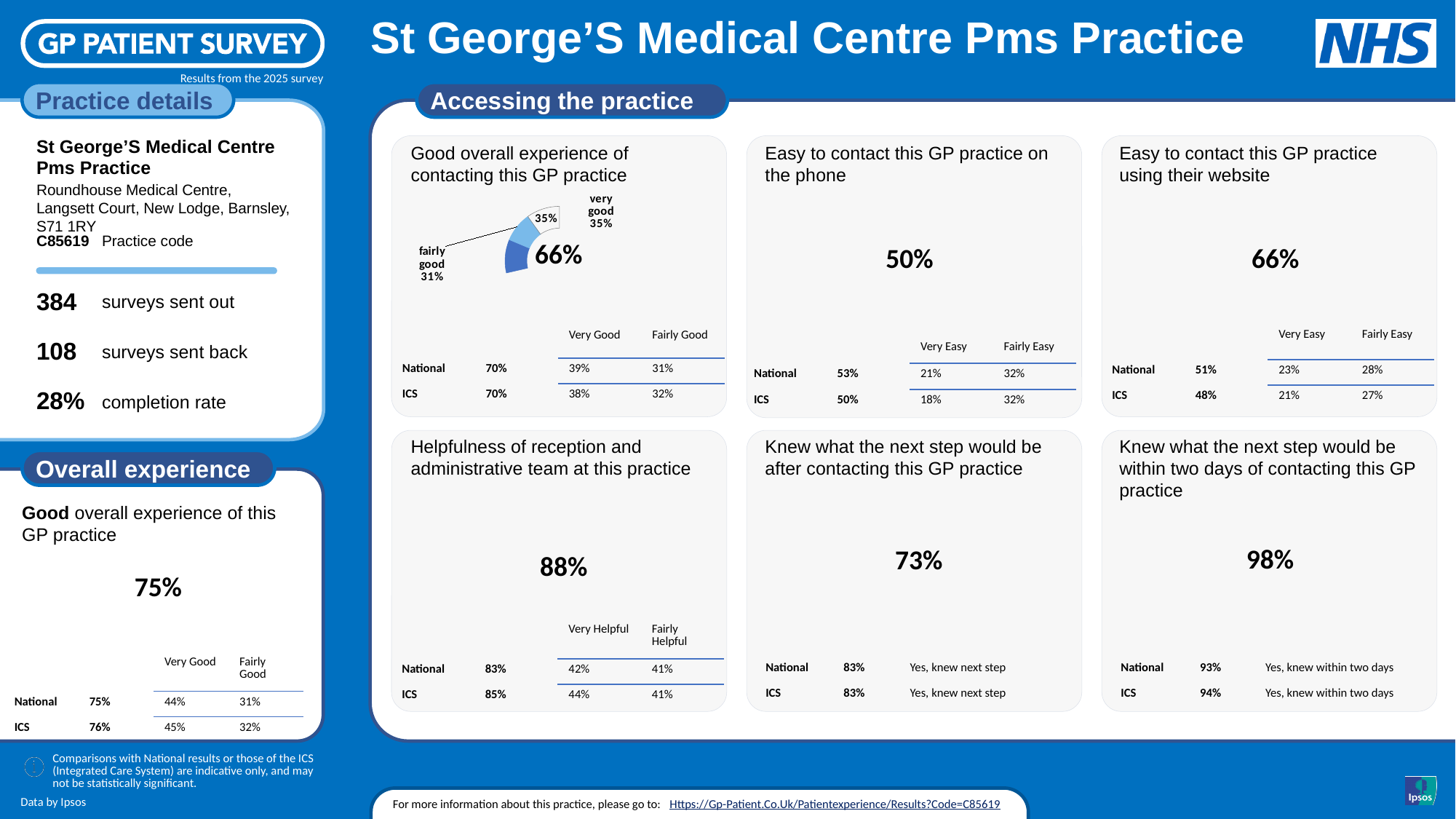
What kind of chart is used in the 'Good overall experience of contacting this GP practice' panel? pie chart In the 'Good overall experience of contacting this GP practice' chart, which slice is drawn in the lighter blue colour? very good In the 'Good overall experience of contacting this GP practice' panel, what is the National figure for 'Very Good'? 39% In the 'Good overall experience of contacting this GP practice' chart, which slice has the smallest value? fairly good In the 'Good overall experience of contacting this GP practice' chart, what is the difference between the 'very good' and 'fairly good' percentages? 4% In the 'Good overall experience of contacting this GP practice' chart, which slice is larger, 'very good' or 'fairly good'? very good In the 'Good overall experience of contacting this GP practice' chart, which slice has the largest value? very good In the 'Good overall experience of contacting this GP practice' panel, what is the ICS figure for 'Fairly Good'? 32% How many labelled slices does the 'Good overall experience of contacting this GP practice' chart show? 2 In the 'Good overall experience of contacting this GP practice' chart, what percentage is labelled 'very good'? 35% In the 'Good overall experience of contacting this GP practice' chart, what percentage is labelled 'fairly good'? 31% In the 'Good overall experience of contacting this GP practice' chart, what is the combined total shown in the centre of the chart? 66%